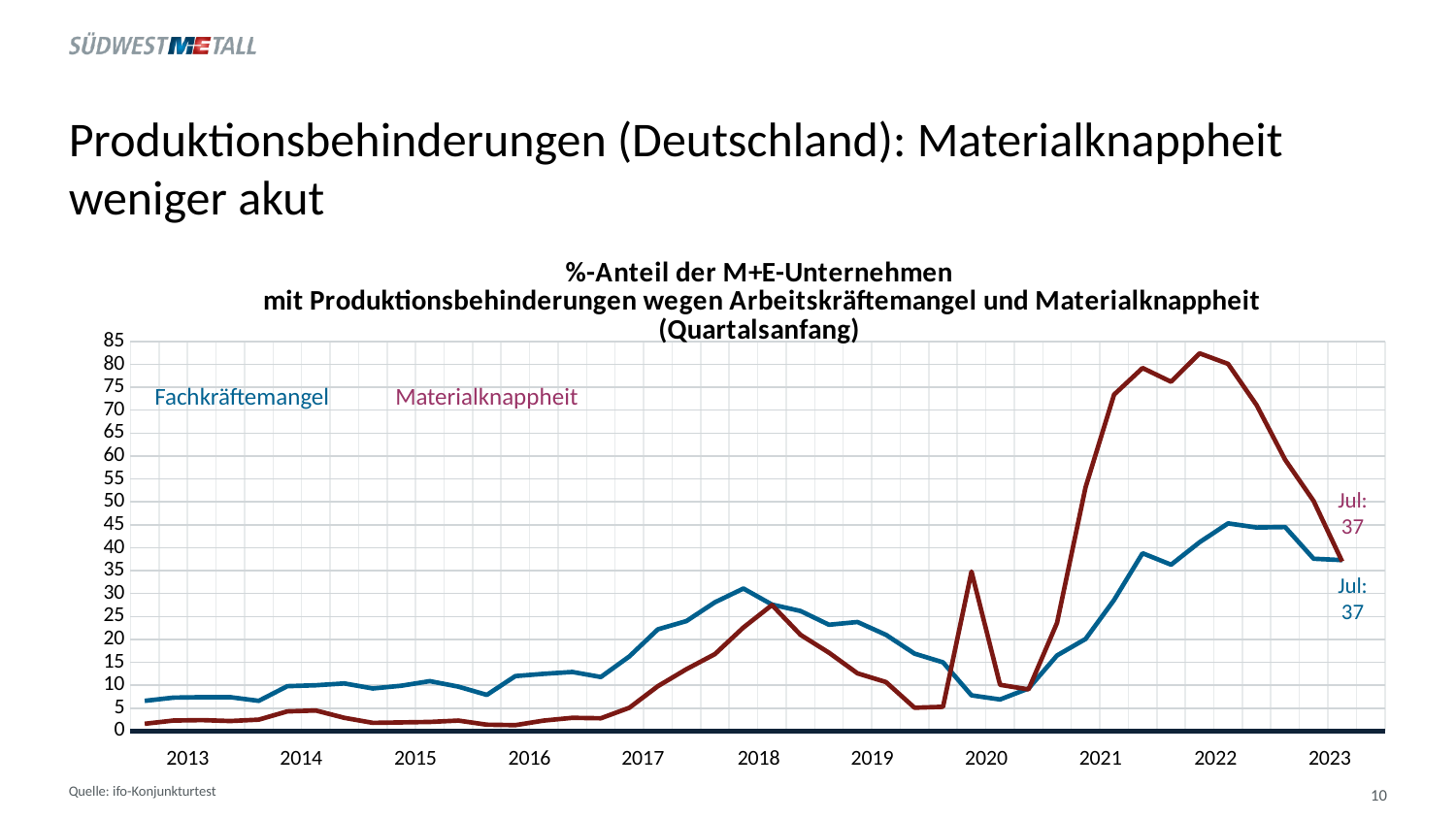
What is the value labelled for Fachkräftemangel in July 2023? 37 At the start of 2022, which series has the higher value, Fachkräftemangel or Materialknappheit? Materialknappheit What kind of chart is shown on the slide? line chart Is the peak value of Materialknappheit greater or less than 75? greater Is the value for Materialknappheit at the start of 2016 greater or less than 5? less Which series reaches the highest value anywhere on the chart? Materialknappheit What is the value labelled for Materialknappheit in July 2023? 37 Does the Fachkräftemangel line rise or fall between 2020 and 2022? rise Does the Materialknappheit line rise or fall between 2022 and 2023? fall Is the value for Fachkräftemangel at the start of 2013 greater or less than 10? less How many series does the chart show? 2 What colour is the Fachkräftemangel line? blue